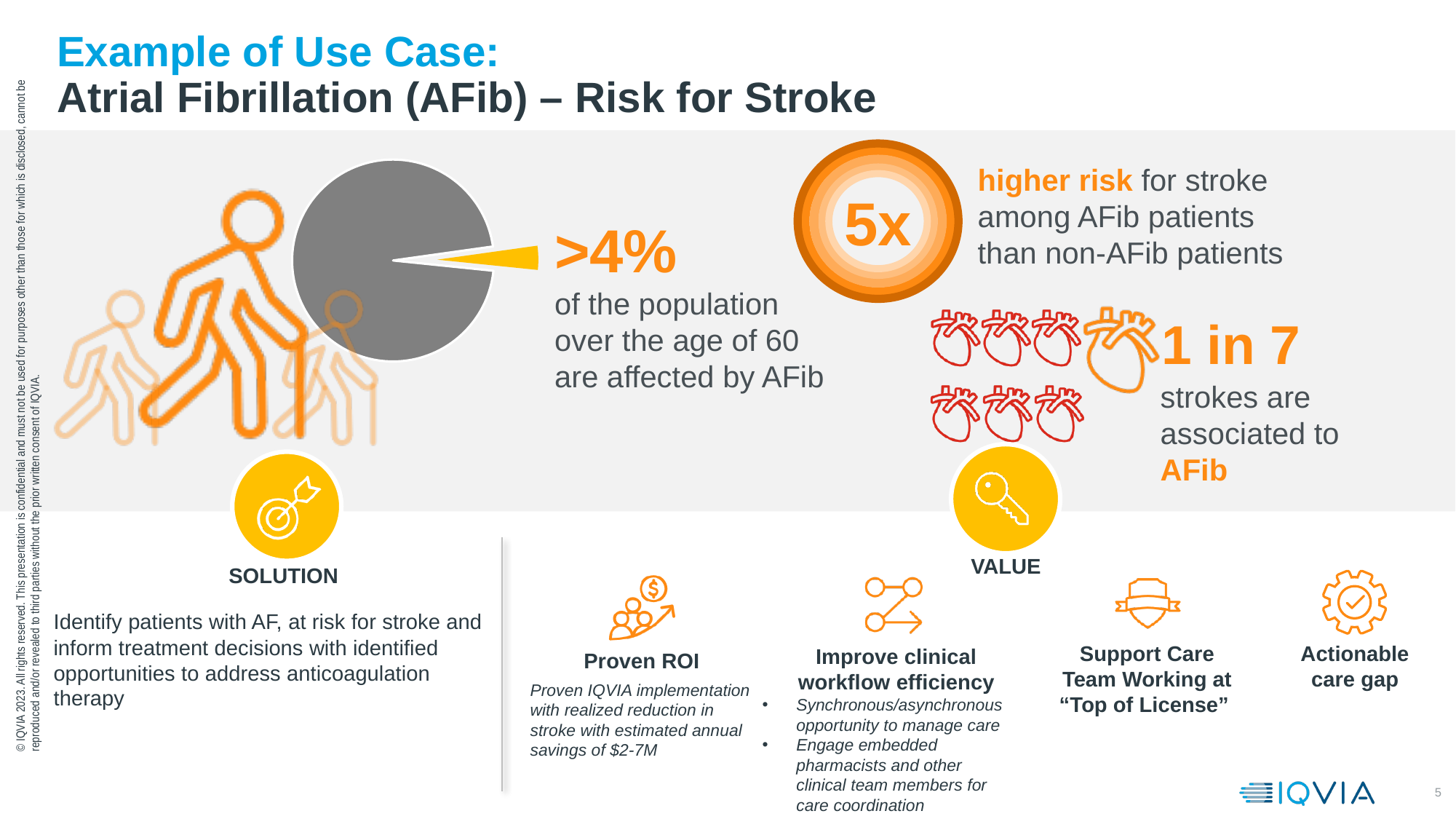
What colour is the small exploded slice of the pie chart? yellow Which slice of the pie chart is the smallest? the yellow slice (>4%) Which slice of the pie chart is larger, the grey slice or the yellow slice? the grey slice What does the pie chart's labelled slice describe, according to the text beside it? the population over the age of 60 affected by AFib How many heart icons are shown in the '1 in 7' pictogram? 7 What share of the population over the age of 60 does the small exploded slice of the pie chart represent? >4% Is the share represented by the yellow slice of the pie chart greater or less than 50%? less What kind of chart is shown next to the walking figures on the slide? pie chart In the heart pictogram, how many hearts are highlighted in orange? 1 How many slices does the pie chart have? 2